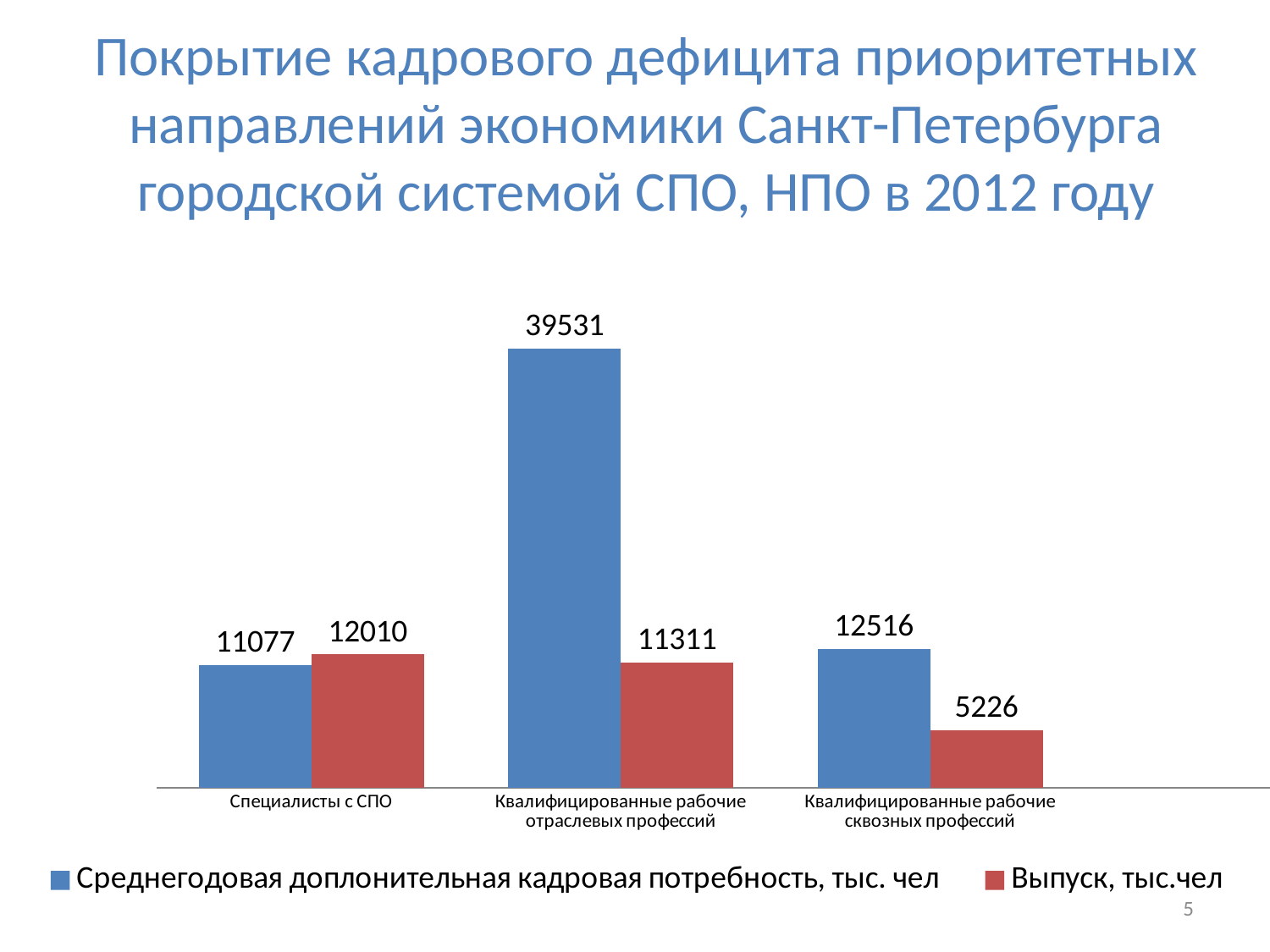
What is the value of 'Выпуск, тыс.чел' for 'Квалифицированные рабочие сквозных профессий'? 5226 For 'Специалисты с СПО', which is larger: 'Среднегодовая дополнительная кадровая потребность, тыс. чел' or 'Выпуск, тыс.чел'? Выпуск, тыс.чел What is the difference between 'Среднегодовая дополнительная кадровая потребность, тыс. чел' and 'Выпуск, тыс.чел' for 'Квалифицированные рабочие отраслевых профессий'? 28220 Which category has the lowest value for 'Выпуск, тыс.чел'? Квалифицированные рабочие сквозных профессий What is the value of 'Среднегодовая дополнительная кадровая потребность, тыс. чел' for 'Квалифицированные рабочие отраслевых профессий'? 39531 How many series does the legend list? 2 What is the value of 'Выпуск, тыс.чел' for 'Специалисты с СПО'? 12010 Which category has the highest value for 'Среднегодовая дополнительная кадровая потребность, тыс. чел'? Квалифицированные рабочие отраслевых профессий What is the difference between 'Среднегодовая дополнительная кадровая потребность, тыс. чел' and 'Выпуск, тыс.чел' for 'Квалифицированные рабочие сквозных профессий'? 7290 How many categories are shown on the x axis? 3 What kind of chart is shown on the slide? Bar chart What is the value of 'Среднегодовая дополнительная кадровая потребность, тыс. чел' for 'Квалифицированные рабочие сквозных профессий'? 12516